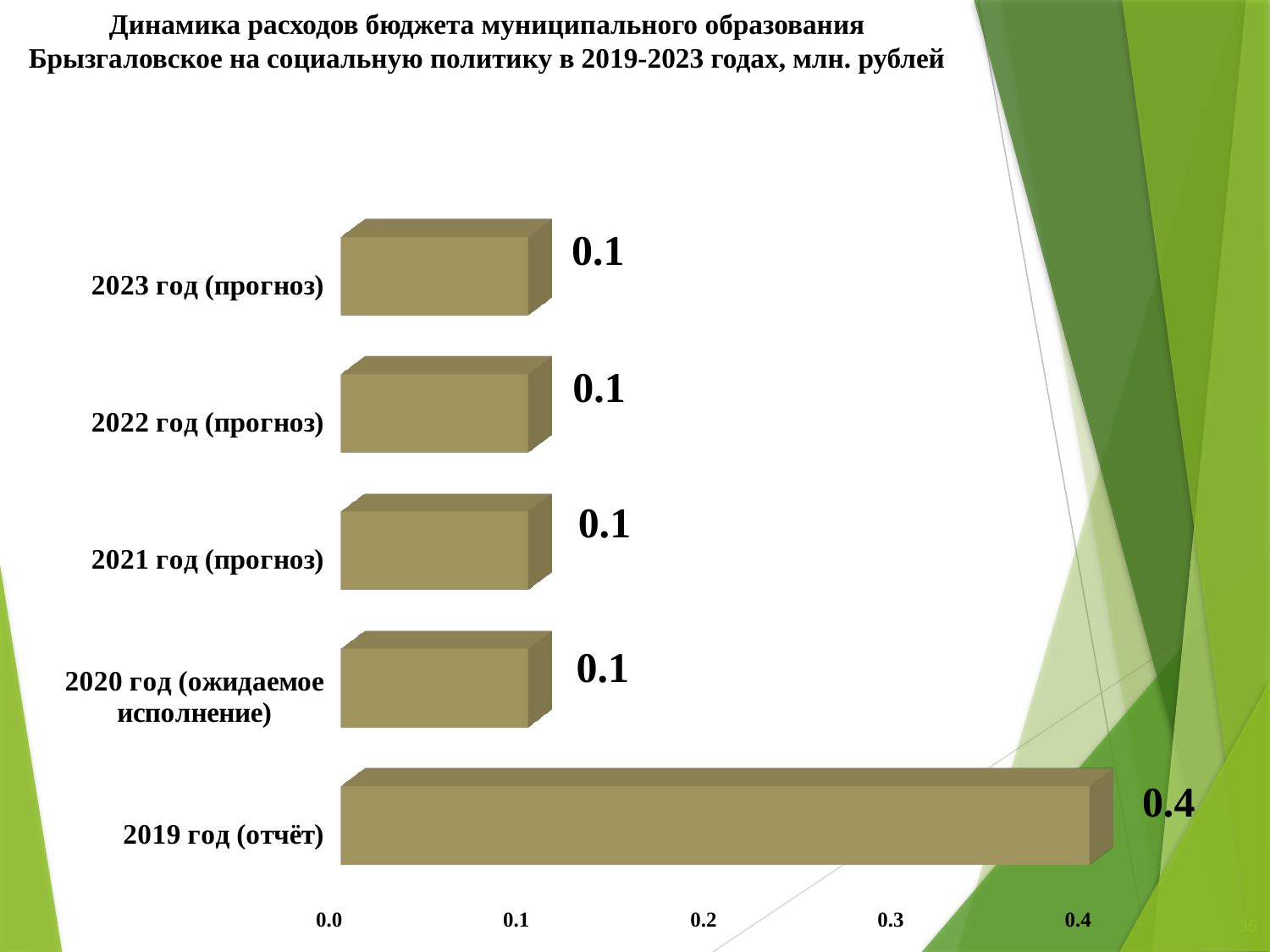
What is the unit of measurement stated in the chart title? млн. рублей How many categories are shown in the chart? 5 What is the difference between the values for 2019 год (отчёт) and 2021 год (прогноз)? 0.3 What is the value for 2020 год (ожидаемое исполнение)? 0.1 What is the value for 2023 год (прогноз)? 0.1 Is the value for 2022 год (прогноз) greater or less than 0.2? less What is the value for 2019 год (отчёт)? 0.4 What is the highest tick value shown on the horizontal axis? 0.4 Which is larger, the value for 2019 год (отчёт) or the value for 2022 год (прогноз)? 2019 год (отчёт) Which category has the highest value? 2019 год (отчёт) What kind of chart is shown on the slide? bar chart Is the value for 2019 год (отчёт) greater or less than 0.3? greater